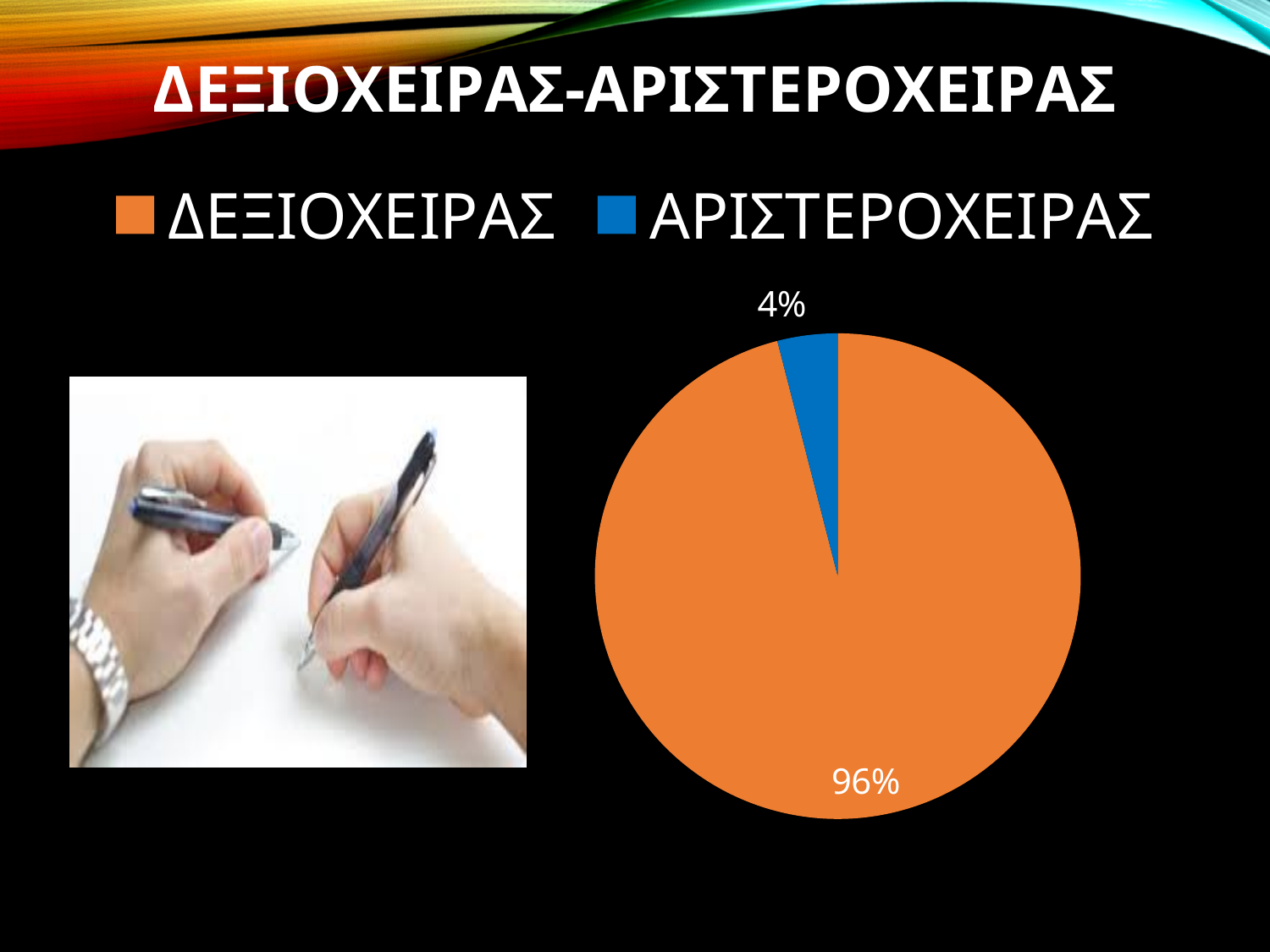
How many entries does the legend list? 2 Which category has the smallest slice of the pie? ΑΡΙΣΤΕΡΟΧΕΙΡΑΣ What is the title of the chart? ΔΕΞΙΟΧΕΙΡΑΣ-ΑΡΙΣΤΕΡΟΧΕΙΡΑΣ How many categories does the pie chart show? 2 What share of the pie does ΔΕΞΙΟΧΕΙΡΑΣ have? 96% Which category has the largest slice of the pie? ΔΕΞΙΟΧΕΙΡΑΣ What share of the pie does ΑΡΙΣΤΕΡΟΧΕΙΡΑΣ have? 4% What is the difference in percentage points between ΔΕΞΙΟΧΕΙΡΑΣ and ΑΡΙΣΤΕΡΟΧΕΙΡΑΣ? 92% Which is larger, the slice for ΔΕΞΙΟΧΕΙΡΑΣ or the slice for ΑΡΙΣΤΕΡΟΧΕΙΡΑΣ? ΔΕΞΙΟΧΕΙΡΑΣ What colour is the slice for ΑΡΙΣΤΕΡΟΧΕΙΡΑΣ? blue What kind of chart is shown on the slide? pie chart